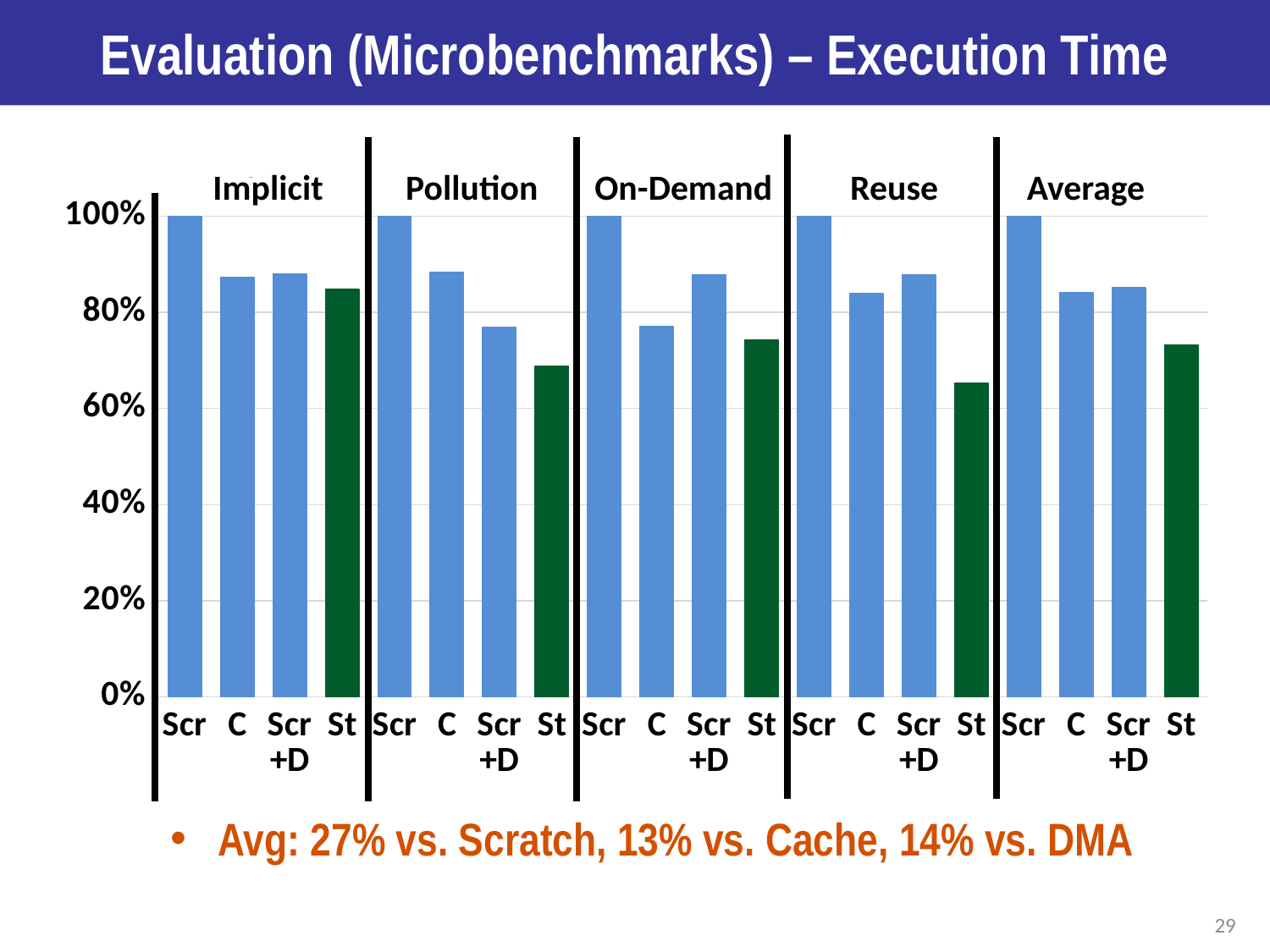
What colour are the St bars? dark green What kind of chart is shown on the slide? bar chart In the Pollution group, which is larger, the C bar or the Scr+D bar? C What is the value of the Scr bar in the Average group? 100% How many benchmark groups are shown along the x axis? 5 How many bars are in each benchmark group? 4 Which bar is the lowest in the Pollution group? St Is the value for St in the Pollution group greater or less than 80%? less Which bar is the highest in the Pollution group? Scr Is the value for St in the Implicit group greater or less than 80%? greater Which bar is the lowest in the Reuse group? St What is the value of the Scr bar in the Implicit group? 100%